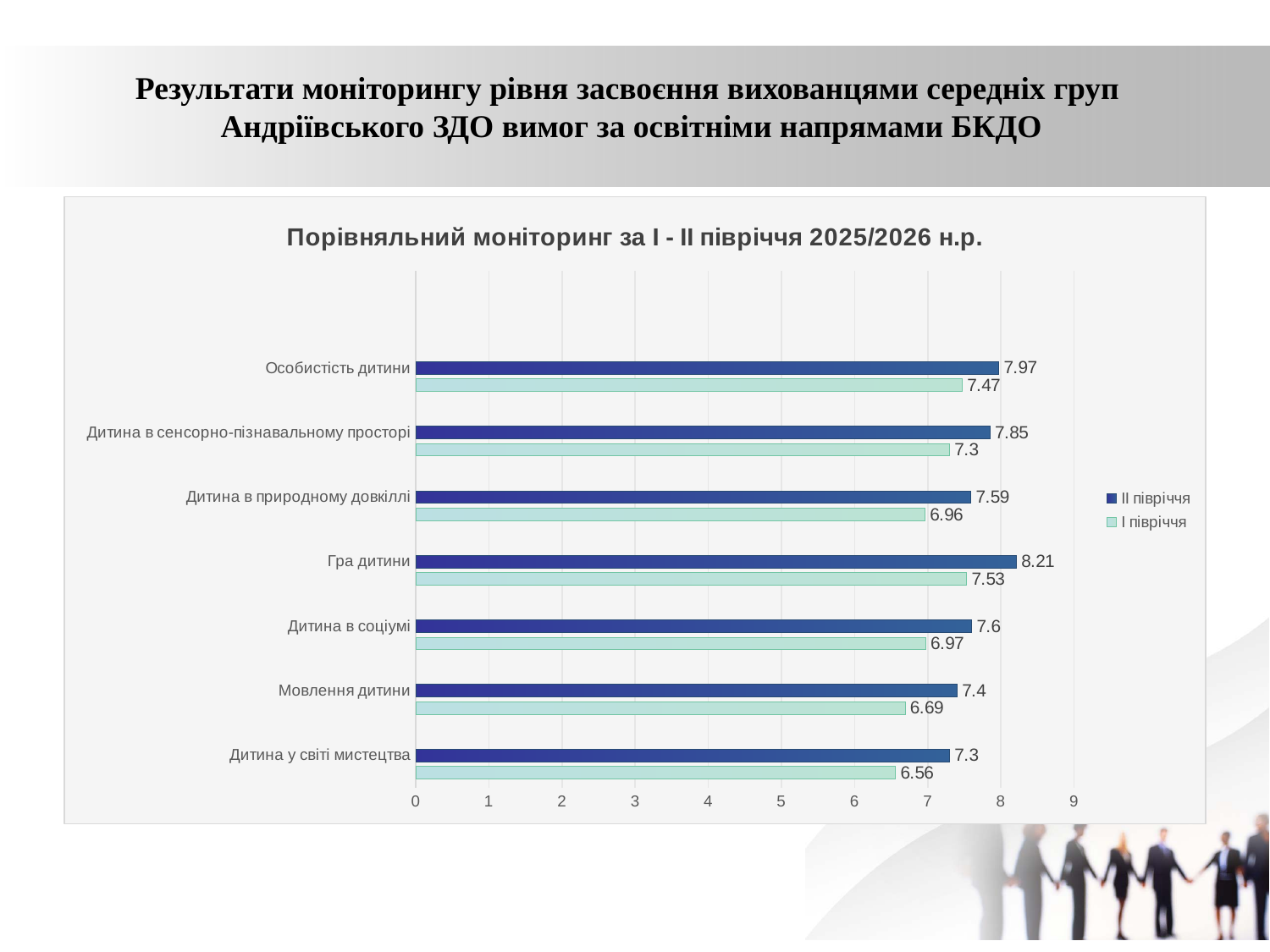
Which category has the lowest value in the "І півріччя" series? Дитина у світі мистецтва What is the difference between the "ІІ півріччя" and "І півріччя" values for "Гра дитини"? 0.68 What is the value for "Дитина в природному довкіллі" in the "ІІ півріччя" series? 7.59 How many categories are shown on the chart? 7 What is the difference between the "ІІ півріччя" and "І півріччя" values for "Особистість дитини"? 0.5 What type of chart is shown on the slide? bar chart What is the value for "Мовлення дитини" in the "І півріччя" series? 6.69 Which category has the highest value in the "ІІ півріччя" series? Гра дитини What is the value for "Гра дитини" in the "ІІ півріччя" series? 8.21 How many series does the legend list? 2 Which is larger: the "І півріччя" value for "Особистість дитини" or the "І півріччя" value for "Дитина в соціумі"? Особистість дитини What is the title of the chart? Порівняльний моніторинг за І - ІІ півріччя 2025/2026 н.р.